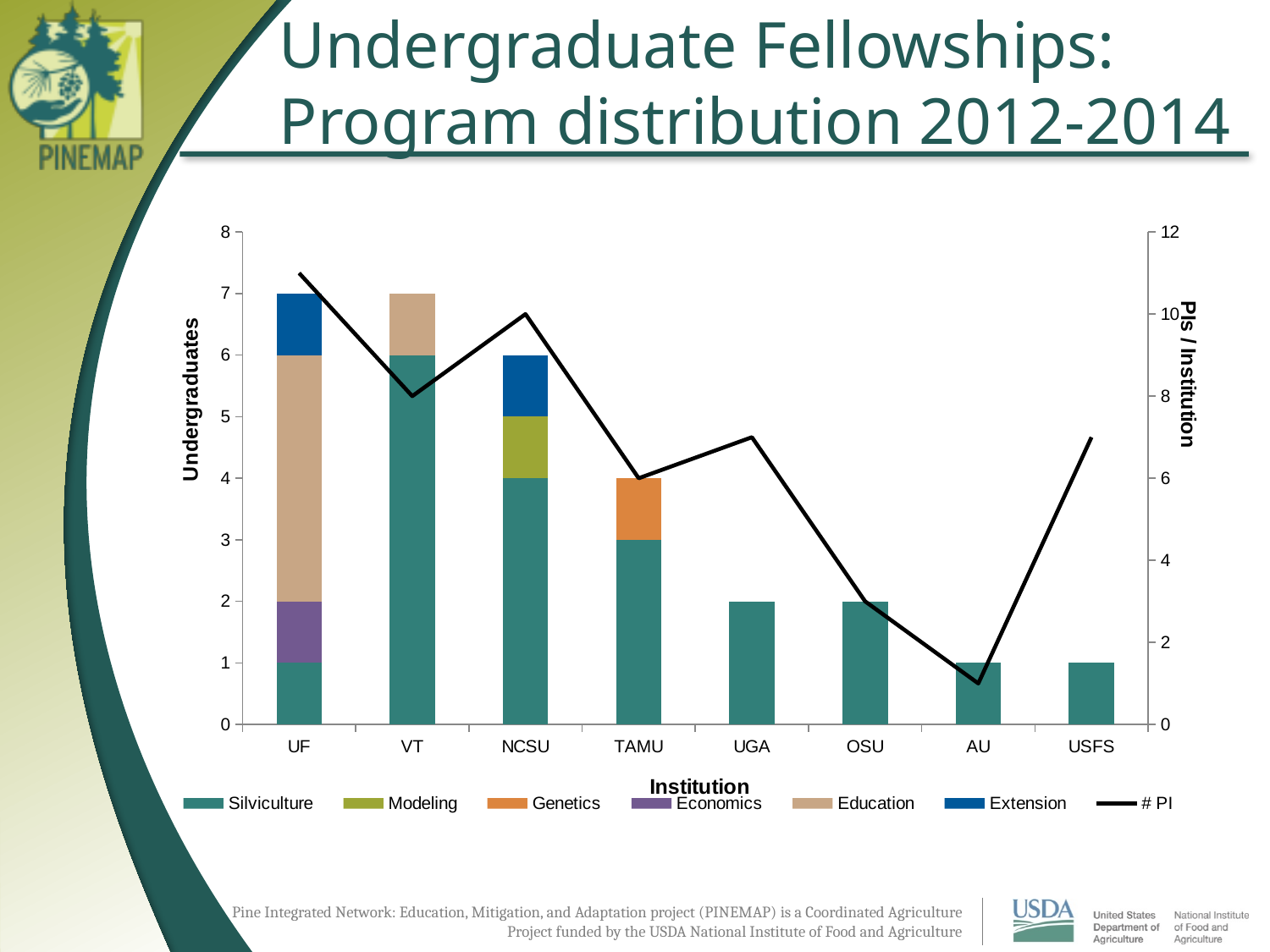
What is the total number of undergraduates for TAMU? 4 How many series does the legend list? 7 What is the # PI value for VT? 8 How many institutions are shown on the x axis? 8 Is the # PI value for UF greater or less than 10? greater Which institution's bar includes a Genetics segment? TAMU What is the total number of undergraduates for UGA? 2 What is the total number of undergraduates for NCSU? 6 Which has more undergraduates in total, NCSU or TAMU? NCSU What is the difference between the total undergraduates for VT and for UGA? 5 What kind of chart is shown on the slide? A stacked bar chart with a line series Is the # PI value for OSU greater or less than 4? less